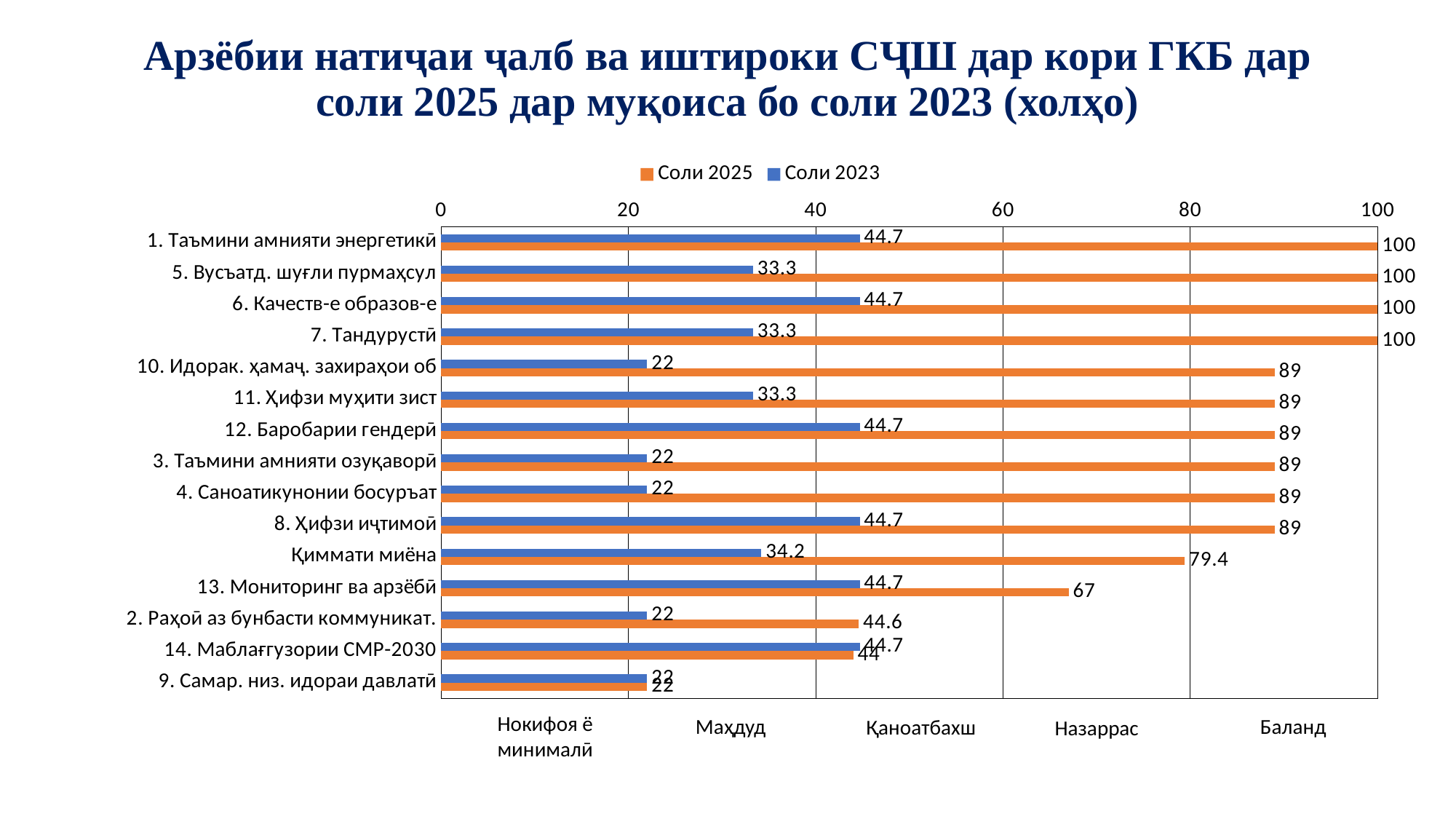
Which category has the lowest Соли 2025 value? 9. Самар. низ. идораи давлатӣ What is the value for Соли 2023 for "10. Идорак. ҳамаҷ. захираҳои об"? 22 What type of chart is shown on the slide? bar chart What is the value for Соли 2025 for "13. Мониторинг ва арзёбӣ"? 67 How many series does the legend list? 2 How many categories are plotted on the chart? 15 What is the value for Соли 2025 for "7. Тандурустӣ"? 100 What is the value for Соли 2025 for "Қиммати миёна"? 79.4 What is the difference between the Соли 2025 and Соли 2023 values for "11. Ҳифзи муҳити зист"? 55.7 Is the Соли 2025 value for "8. Ҳифзи иҷтимоӣ" greater or less than 80? greater Which is larger for "2. Раҳоӣ аз бунбасти коммуникат.": the Соли 2025 value or the Соли 2023 value? Соли 2025 Which colour represents the Соли 2023 series? blue